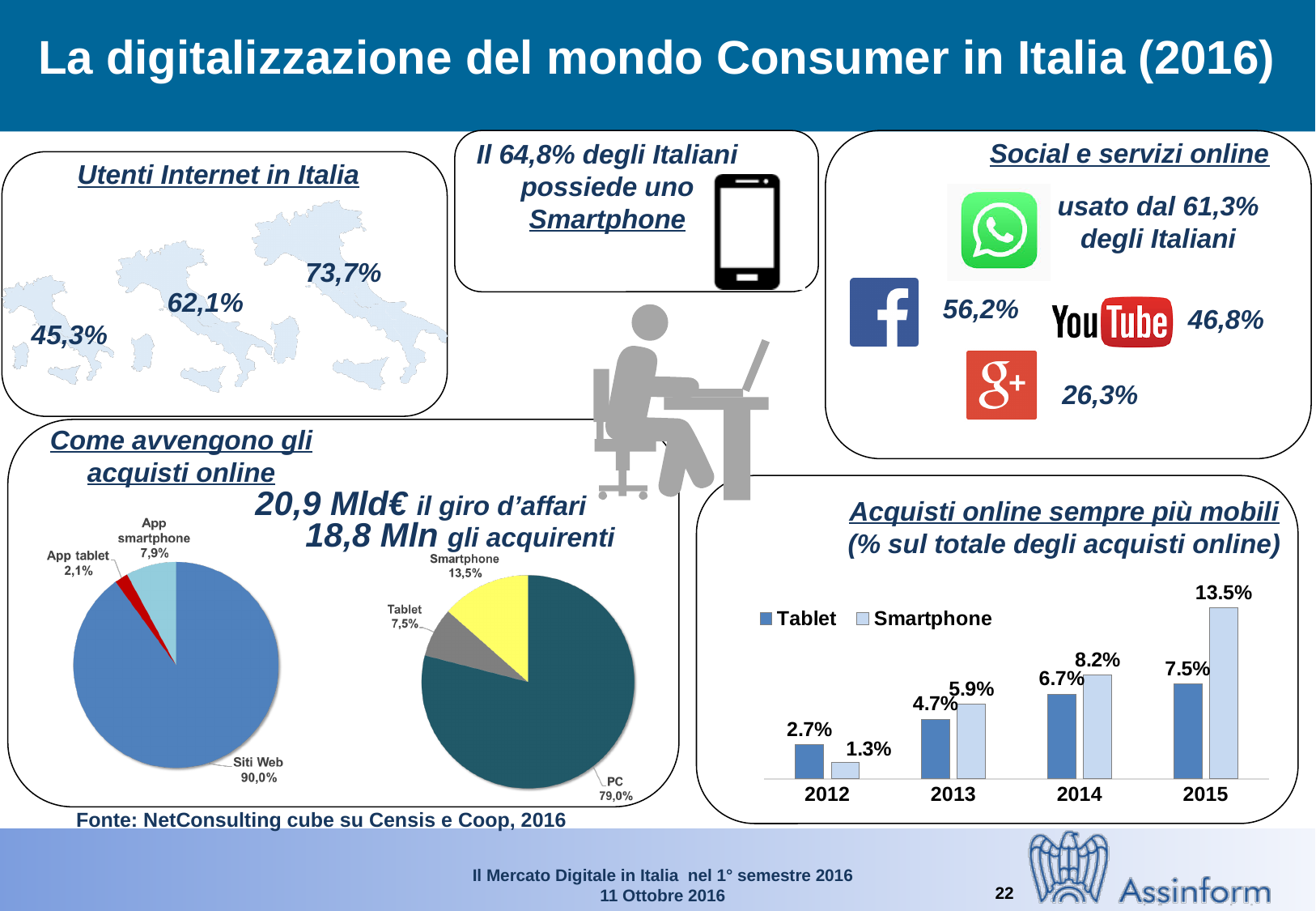
In the bar chart 'Acquisti online sempre più mobili', what is the value for Smartphone in 2015? 13.5% In the bar chart 'Acquisti online sempre più mobili', how many series does the legend list? 2 In the bar chart 'Acquisti online sempre più mobili', does the Smartphone value rise or fall from 2012 to 2015? rise In the bar chart 'Acquisti online sempre più mobili', which year has the highest Smartphone value? 2015 In the bar chart 'Acquisti online sempre più mobili', what is the difference between the Smartphone and Tablet values in 2015? 6.0% What kind of chart is used for 'Acquisti online sempre più mobili'? bar chart In the bar chart 'Acquisti online sempre più mobili', which is larger in 2012, Tablet or Smartphone? Tablet In the bar chart 'Acquisti online sempre più mobili', which year has the lowest Tablet value? 2012 In the bar chart 'Acquisti online sempre più mobili', how many years are shown on the x axis? 4 In the right pie chart under 'Come avvengono gli acquisti online', what share is PC? 79,0% In the bar chart 'Acquisti online sempre più mobili', what is the value for Tablet in 2012? 2.7% In the left pie chart under 'Come avvengono gli acquisti online', what share is Siti Web? 90,0%